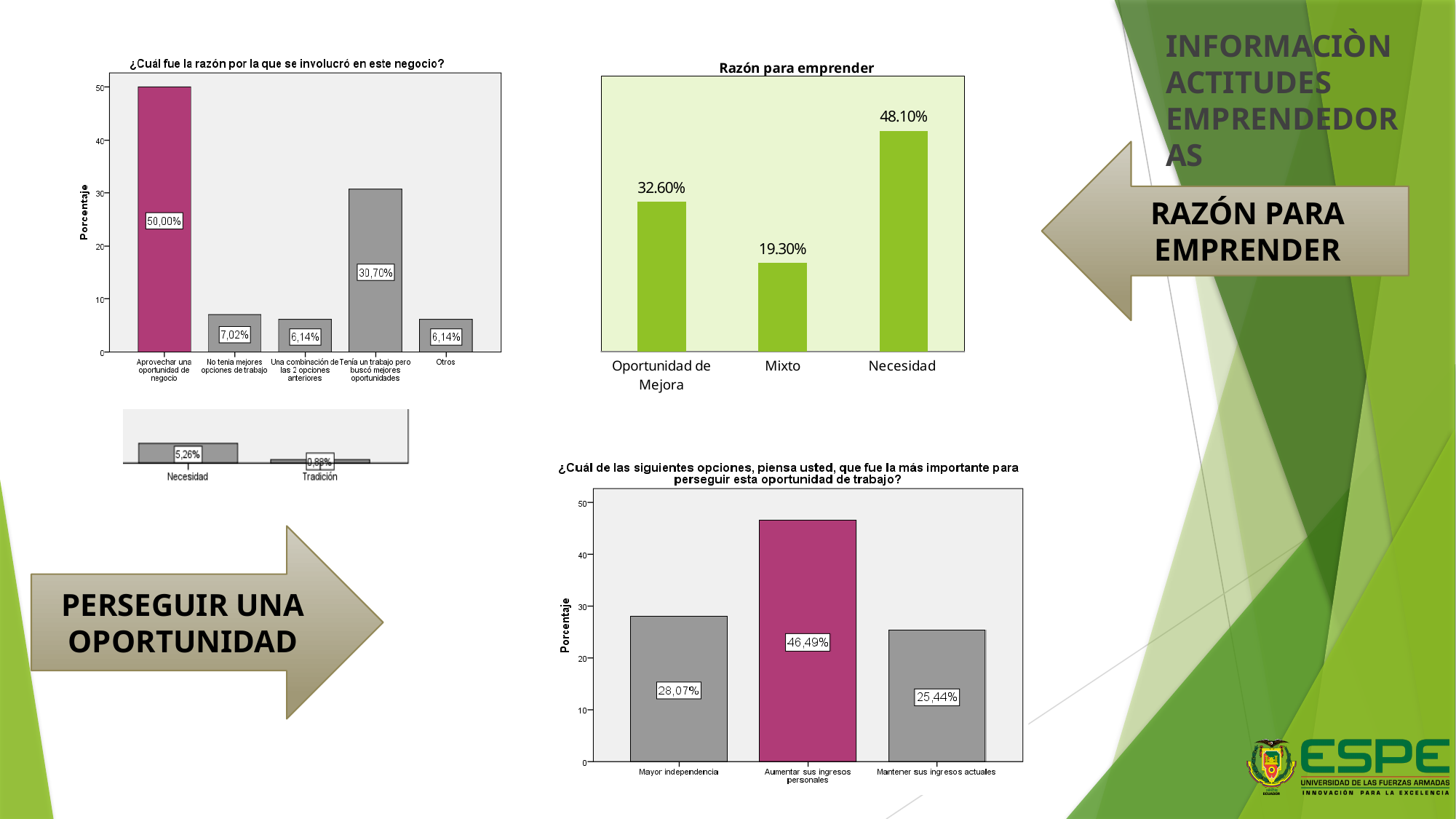
In the bottom chart '¿Cuál de las siguientes opciones, piensa usted, que fue la más importante para perseguir esta oportunidad de trabajo?', what is the difference between 'Mayor independencia' and 'Mantener sus ingresos actuales'? 2,63% In the bottom chart '¿Cuál de las siguientes opciones, piensa usted, que fue la más importante para perseguir esta oportunidad de trabajo?', which category has the lowest value? Mantener sus ingresos actuales In the top-left chart '¿Cuál fue la razón por la que se involucró en este negocio?', which is larger: 'No tenía mejores opciones de trabajo' or 'Otros'? No tenía mejores opciones de trabajo In the top-left chart '¿Cuál fue la razón por la que se involucró en este negocio?', what is the value for 'Tenía un trabajo pero buscó mejores oportunidades'? 30,70% In the 'Razón para emprender' chart, which category has the lowest value? Mixto In the bottom chart '¿Cuál de las siguientes opciones, piensa usted, que fue la más importante para perseguir esta oportunidad de trabajo?', what is the value for 'Aumentar sus ingresos personales'? 46,49% How many categories are shown in the 'Razón para emprender' chart? 3 What is the y-axis label of the bottom chart '¿Cuál de las siguientes opciones, piensa usted, que fue la más importante para perseguir esta oportunidad de trabajo?'? Porcentaje What type of chart is the 'Razón para emprender' chart? Bar chart In the top-left chart '¿Cuál fue la razón por la que se involucró en este negocio?', what is the value for 'Aprovechar una oportunidad de negocio'? 50,00% In the 'Razón para emprender' chart, what is the value for Necesidad? 48.10% In the 'Razón para emprender' chart, what is the difference between Necesidad and Oportunidad de Mejora? 15.50%